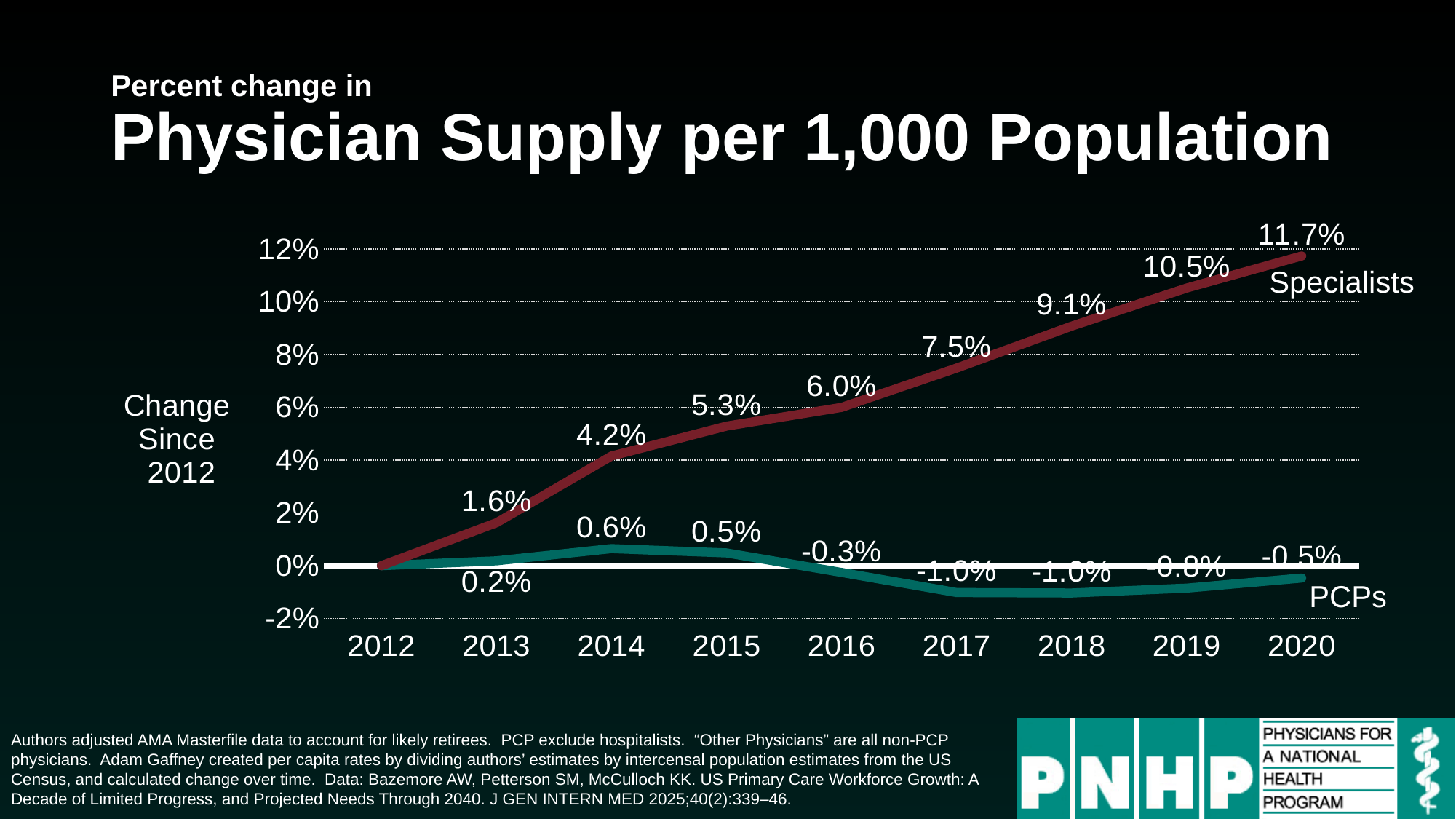
What is the value for PCPs in 2017? -1.0% What is the value for PCPs in 2014? 0.6% In which year does the Specialists line reach its highest value? 2020 What is the value for Specialists in 2020? 11.7% What is the difference between the Specialists and PCPs values in 2020? 12.2% Does the Specialists line rise or fall from 2012 to 2020? Rises What is the label on the y axis of the chart? Change Since 2012 Which series has the larger value in 2016, Specialists or PCPs? Specialists What is the value for Specialists in 2015? 5.3% How many years are shown on the x axis? 9 How many series are plotted on the chart? 2 What kind of chart is shown on the slide? Line chart